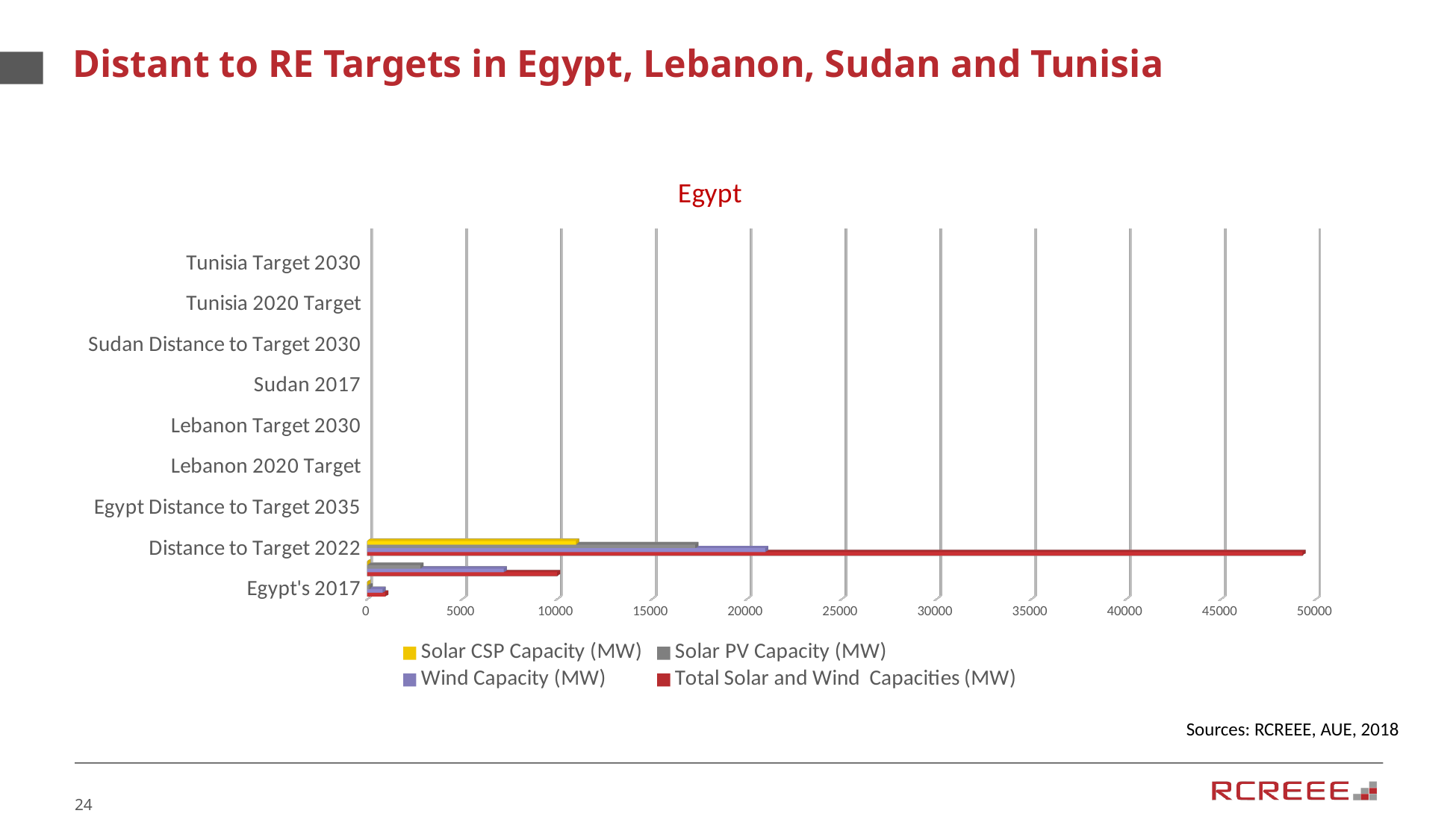
Which series has the longest bar for Distance to Target 2022? Total Solar and Wind Capacities (MW) What kind of chart is shown on the slide? Bar chart Which colour represents Solar CSP Capacity (MW) in the legend? Yellow How many categories are listed on the vertical axis of the chart? 9 Is the Solar PV Capacity value for Distance to Target 2022 greater or less than 15000? greater How many series does the legend list? 4 Is the Total Solar and Wind Capacities value for Egypt's 2017 greater or less than 5000? less For Distance to Target 2022, which is larger: Wind Capacity or Solar CSP Capacity? Wind Capacity What is the title shown above the chart? Egypt Is the Total Solar and Wind Capacities value for Distance to Target 2022 greater or less than 45000? greater Which series has the shortest bar for Distance to Target 2022? Solar CSP Capacity (MW)